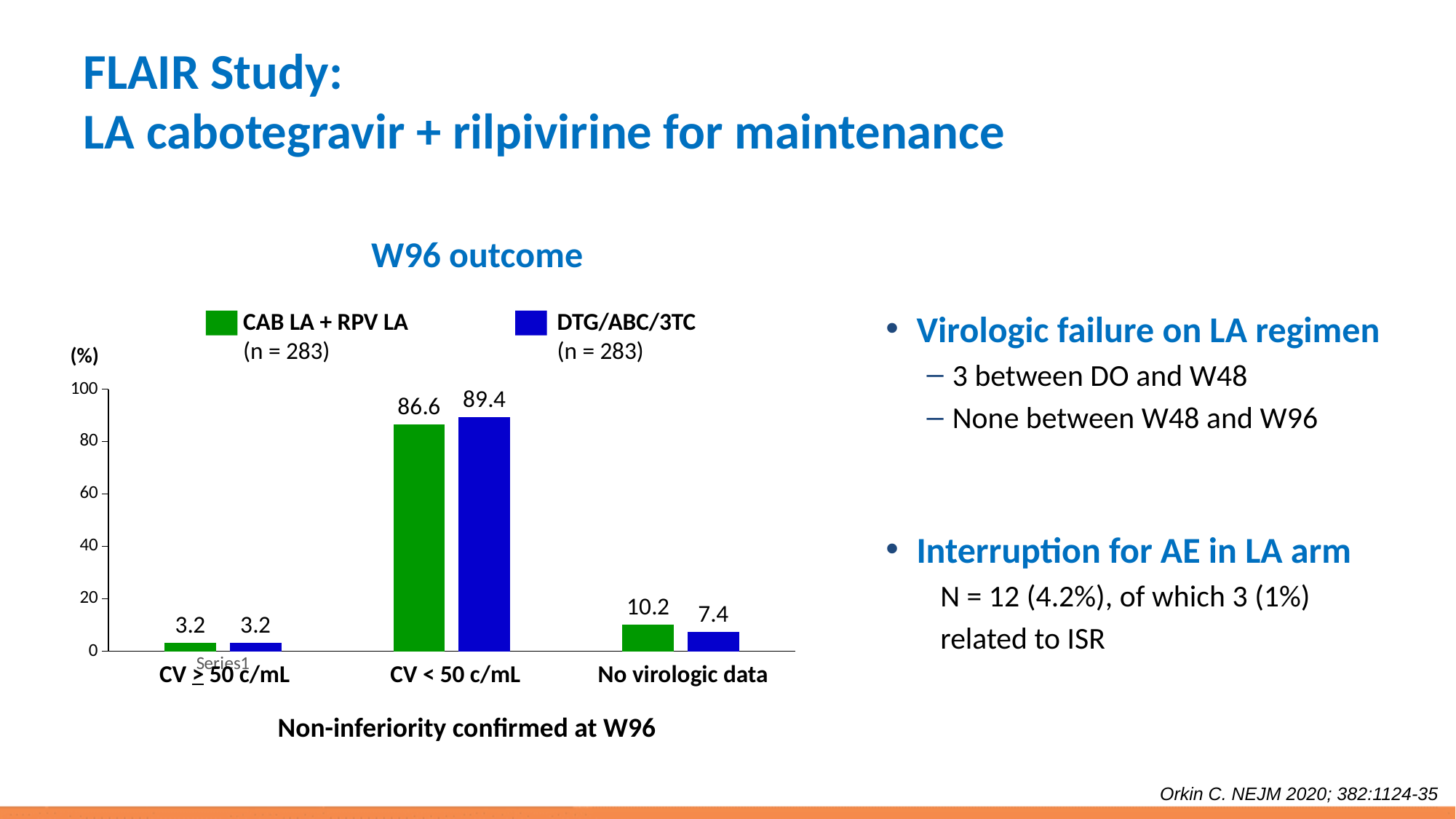
In the No virologic data category, which series has the larger value? CAB LA + RPV LA Is the value for DTG/ABC/3TC in the No virologic data category greater or less than 20? less What is the difference between the DTG/ABC/3TC and CAB LA + RPV LA values in the CV < 50 c/mL category? 2.8 What is the value for DTG/ABC/3TC in the CV ≥ 50 c/mL category? 3.2 Which category has the lowest value for CAB LA + RPV LA? CV ≥ 50 c/mL Which category has the highest value for DTG/ABC/3TC? CV < 50 c/mL What is the value for CAB LA + RPV LA in the CV < 50 c/mL category? 86.6 How many series does the legend list? 2 What kind of chart is shown on the slide? bar chart What is the value for DTG/ABC/3TC in the CV < 50 c/mL category? 89.4 What is the value for CAB LA + RPV LA in the No virologic data category? 10.2 How many categories are shown on the x axis? 3